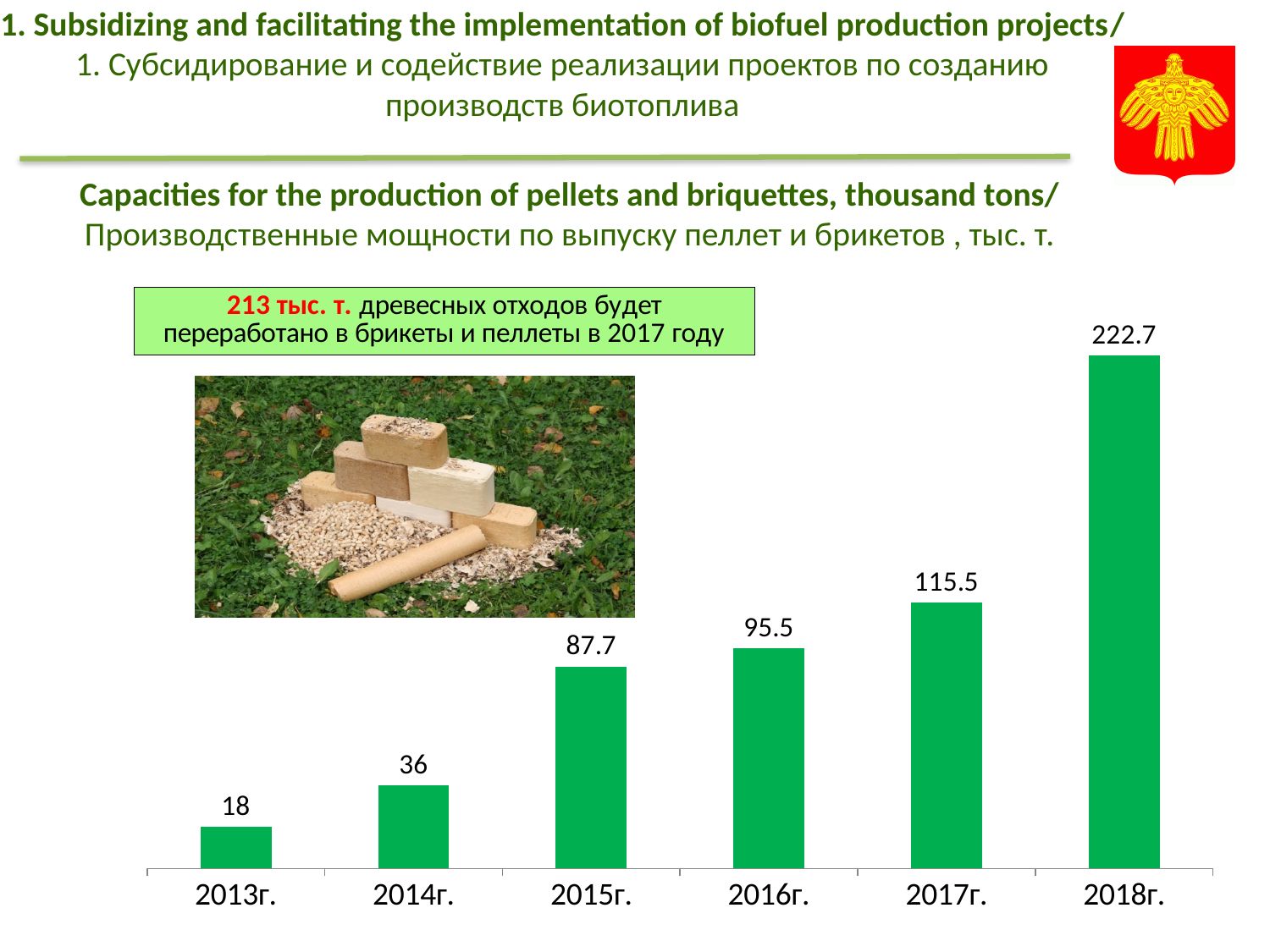
What is the difference between the values for 2014г. and 2013г.? 18 What is the value for 2013г.? 18 Which year has the lowest value? 2013г. What kind of chart is shown? bar chart What unit is given in the chart title for the capacities? thousand tons What is the value for 2016г.? 95.5 What is the value for 2018г.? 222.7 Which year has the highest value? 2018г. Which is larger, the value for 2015г. or the value for 2016г.? 2016г. Do the values rise or fall from 2013г. to 2018г.? rise What is the difference between the values for 2018г. and 2017г.? 107.2 How many years are shown on the x axis? 6